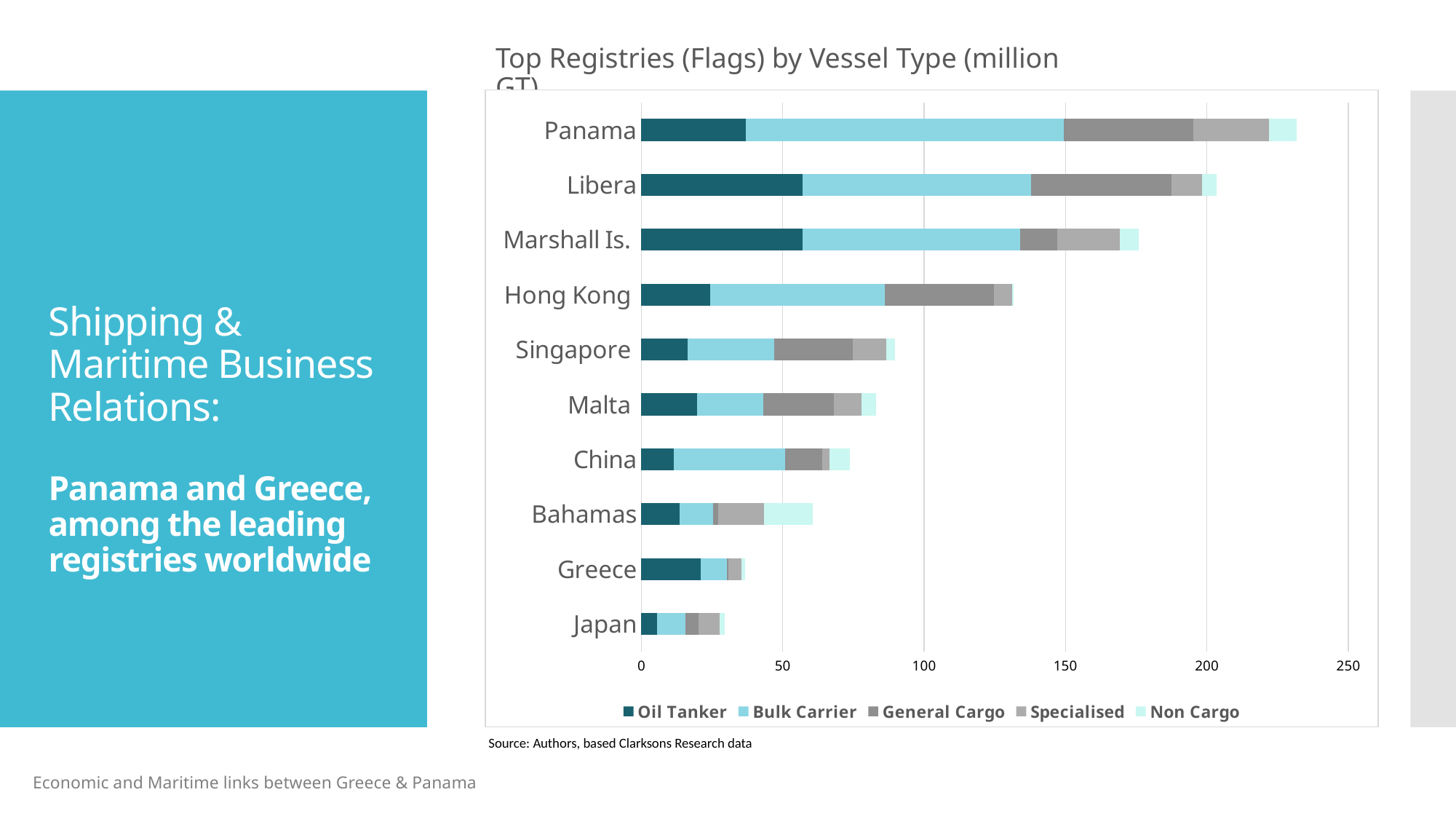
How many vessel types does the legend list? 5 Is the total value for Hong Kong greater or less than 100? greater Is the total value for Marshall Is. greater or less than 200? less How many registries (flags) are listed on the chart? 10 What is the first vessel type listed in the legend? Oil Tanker Which registry has the smallest total bar? Japan Is the total value for Panama greater or less than 200? greater What kind of chart is shown on the slide? Stacked bar chart Which registry has the largest total bar? Panama Which has a larger total bar, Greece or Bahamas? Bahamas Which has a larger total bar, Hong Kong or Malta? Hong Kong